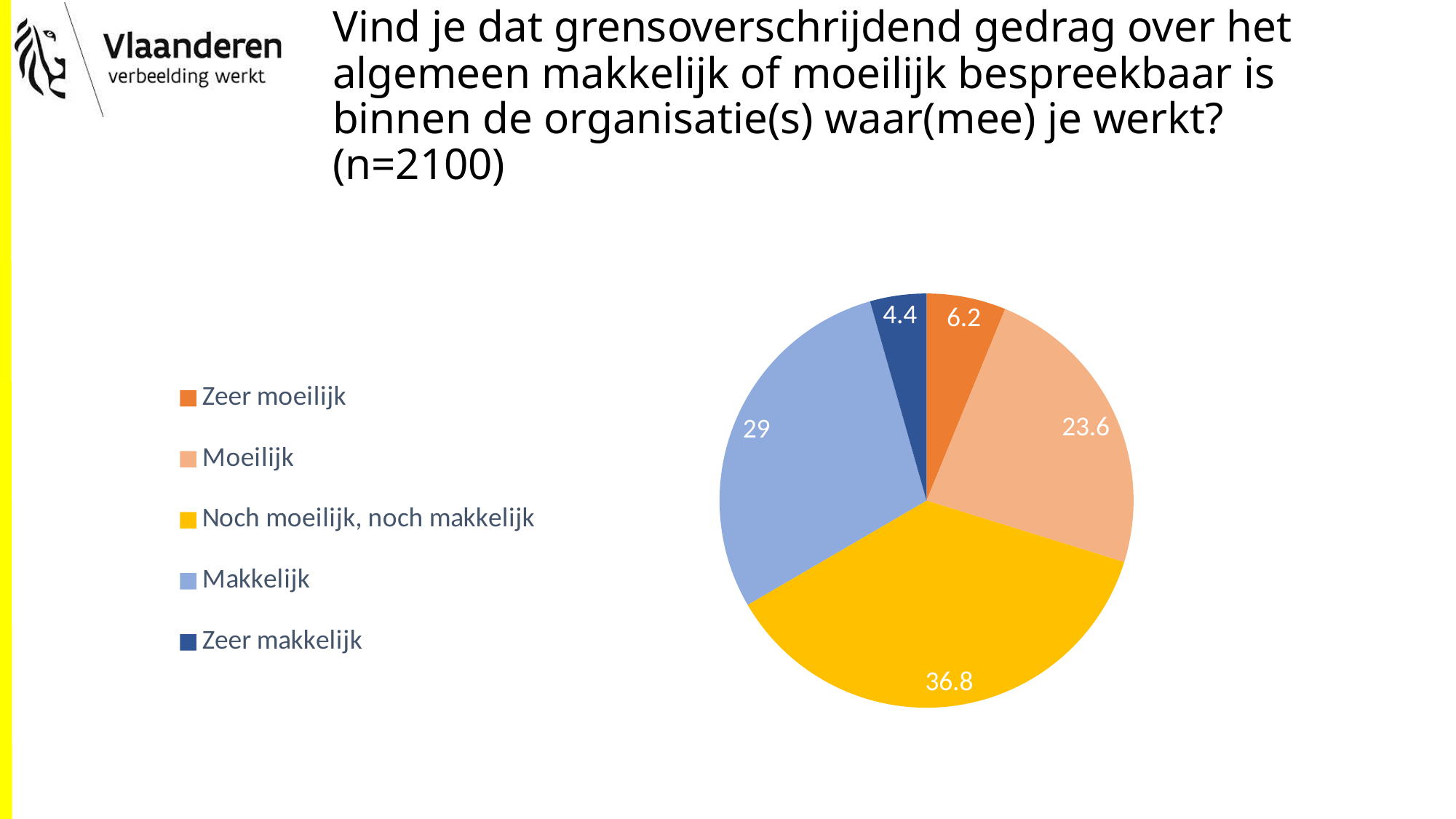
What is the difference between the values for "Noch moeilijk, noch makkelijk" and "Makkelijk"? 7.8 Which is larger, the value for "Zeer moeilijk" or the value for "Zeer makkelijk"? Zeer moeilijk Which category has the smallest slice? Zeer makkelijk What is the value for "Makkelijk"? 29 What kind of chart is shown on the slide? pie chart What is the value for "Zeer makkelijk"? 4.4 What is the value for "Noch moeilijk, noch makkelijk"? 36.8 What is the value for "Zeer moeilijk"? 6.2 How many categories does the pie chart have? 5 Which category has the largest slice? Noch moeilijk, noch makkelijk What colour is the slice for "Noch moeilijk, noch makkelijk"? yellow What is the difference between the values for "Makkelijk" and "Moeilijk"? 5.4